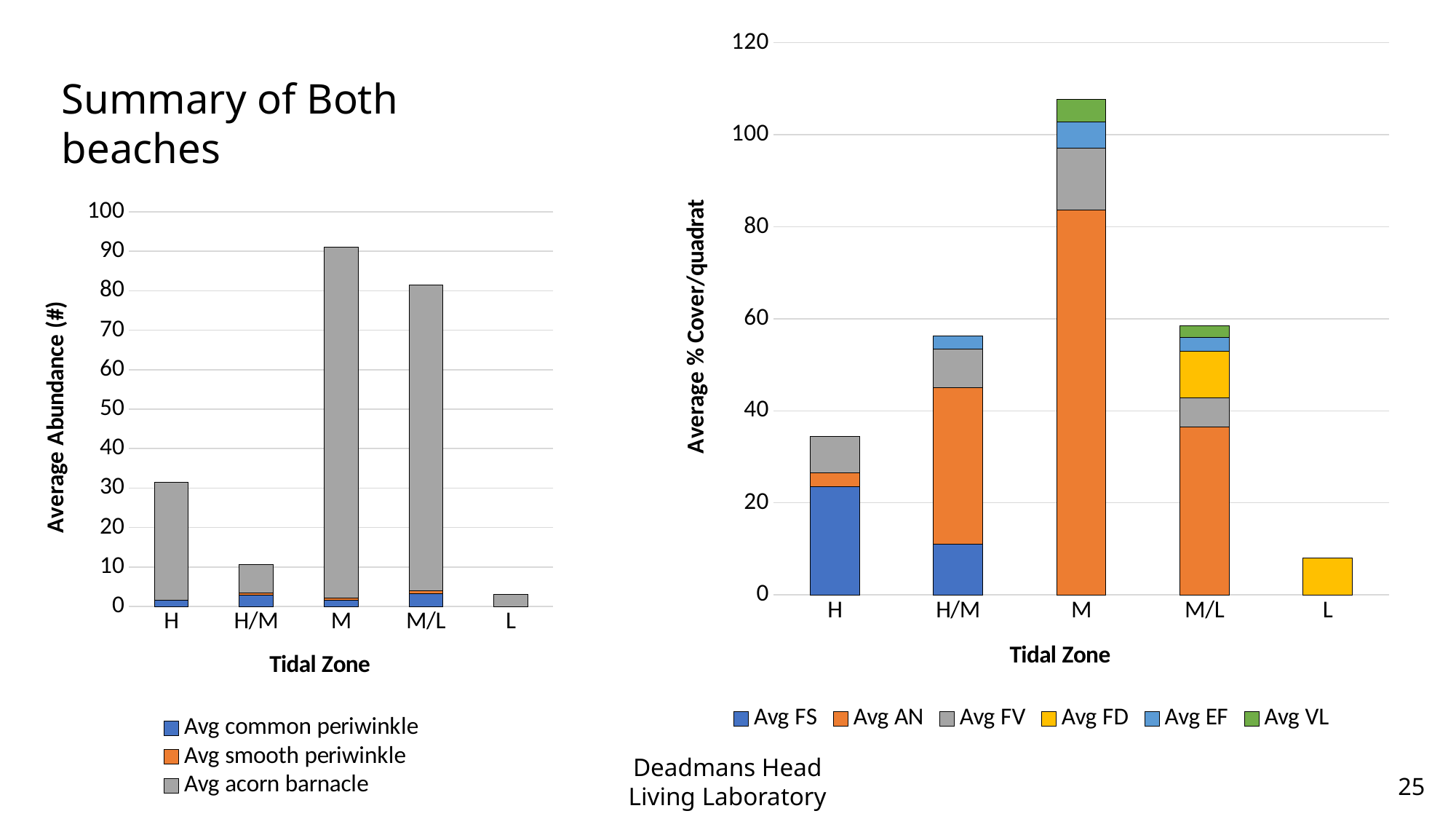
On the left chart (Average Abundance), which tidal zone has the shortest bar? L On the right chart (Average % Cover/quadrat), which tidal zone has the tallest bar? M On the left chart (Average Abundance), is the total for H greater or less than 40? less How many tidal zone categories are shown on the left chart (Average Abundance)? 5 How many series does the legend of the right chart (Average % Cover/quadrat) list? 6 What kind of chart is the left chart (Average Abundance)? stacked bar chart How many series does the legend of the left chart (Average Abundance) list? 3 On the right chart (Average % Cover/quadrat), which bar is taller, H or H/M? H/M On the right chart (Average % Cover/quadrat), is the total for M greater or less than 100? greater On the left chart (Average Abundance), which tidal zone has the tallest bar? M On the right chart (Average % Cover/quadrat), which series is the only one present in the L bar? Avg FD On the left chart (Average Abundance), is the total for M greater or less than 80? greater